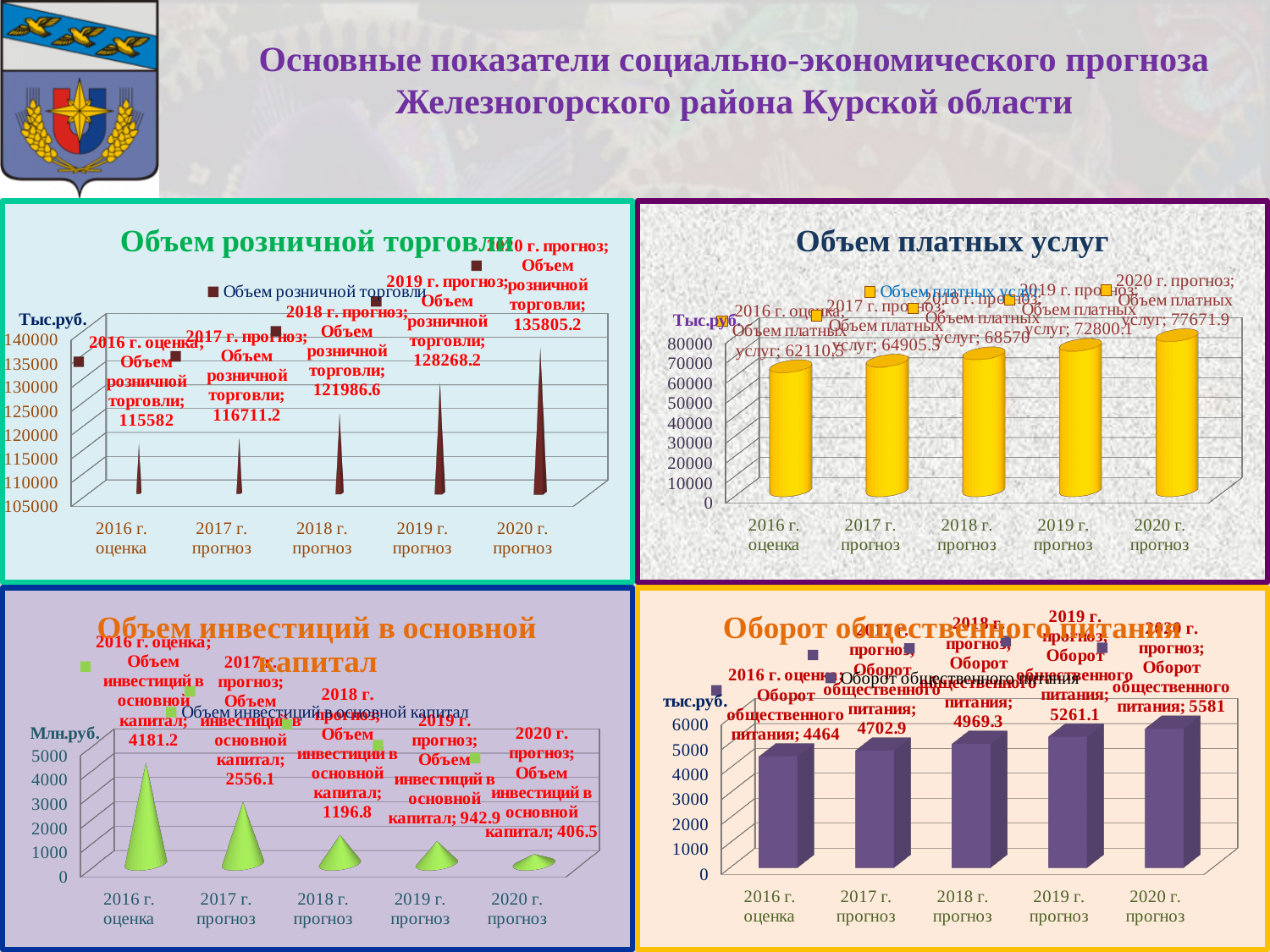
In the 'Объем инвестиций в основной капитал' chart, what is the value for 2017 г. прогноз? 2556.1 In the 'Объем платных услуг' chart, which year has the highest value? 2020 г. прогноз In the 'Объем платных услуг' chart, what is the difference between the 2020 г. прогноз and 2016 г. оценка values? 15561.4 In the 'Объем розничной торговли' chart, do the values rise or fall from 2016 to 2020? rise In the 'Оборот общественного питания' chart, which is larger: the value for 2016 г. оценка or 2020 г. прогноз? 2020 г. прогноз In the 'Объем инвестиций в основной капитал' chart, do the values rise or fall from 2016 to 2020? fall How many categories are shown on the x axis of the 'Оборот общественного питания' chart? 5 In the 'Объем инвестиций в основной капитал' chart, which year has the lowest value? 2020 г. прогноз In the 'Объем розничной торговли' chart, what is the value for 2016 г. оценка? 115582 In the 'Объем розничной торговли' chart, what is the value for 2020 г. прогноз? 135805.2 In the 'Оборот общественного питания' chart, what is the value for 2019 г. прогноз? 5261.1 In the 'Объем платных услуг' chart, what is the value for 2018 г. прогноз? 68570